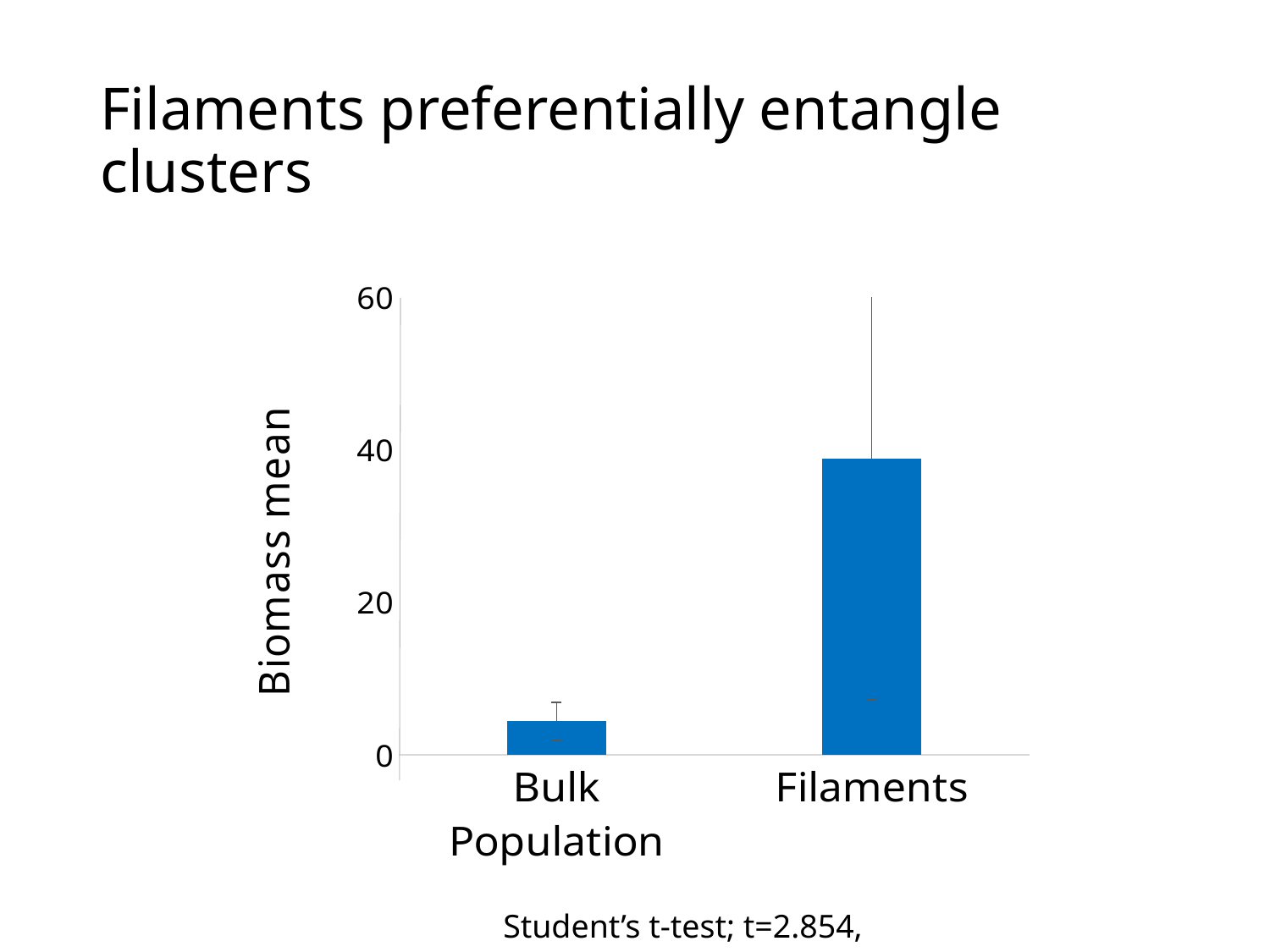
Which category has the highest biomass mean? Filaments What is the label of the y axis? Biomass mean What is the title of the slide containing the chart? Filaments preferentially entangle clusters Is the value for Filaments greater or less than 60? less Which is larger, the biomass mean for Bulk Population or for Filaments? Filaments How many categories are plotted on the x axis? 2 Which category has the lowest biomass mean? Bulk Population Is the value for Bulk Population greater or less than 20? less Is the value for Filaments greater or less than 20? greater What kind of chart is shown on the slide? bar chart